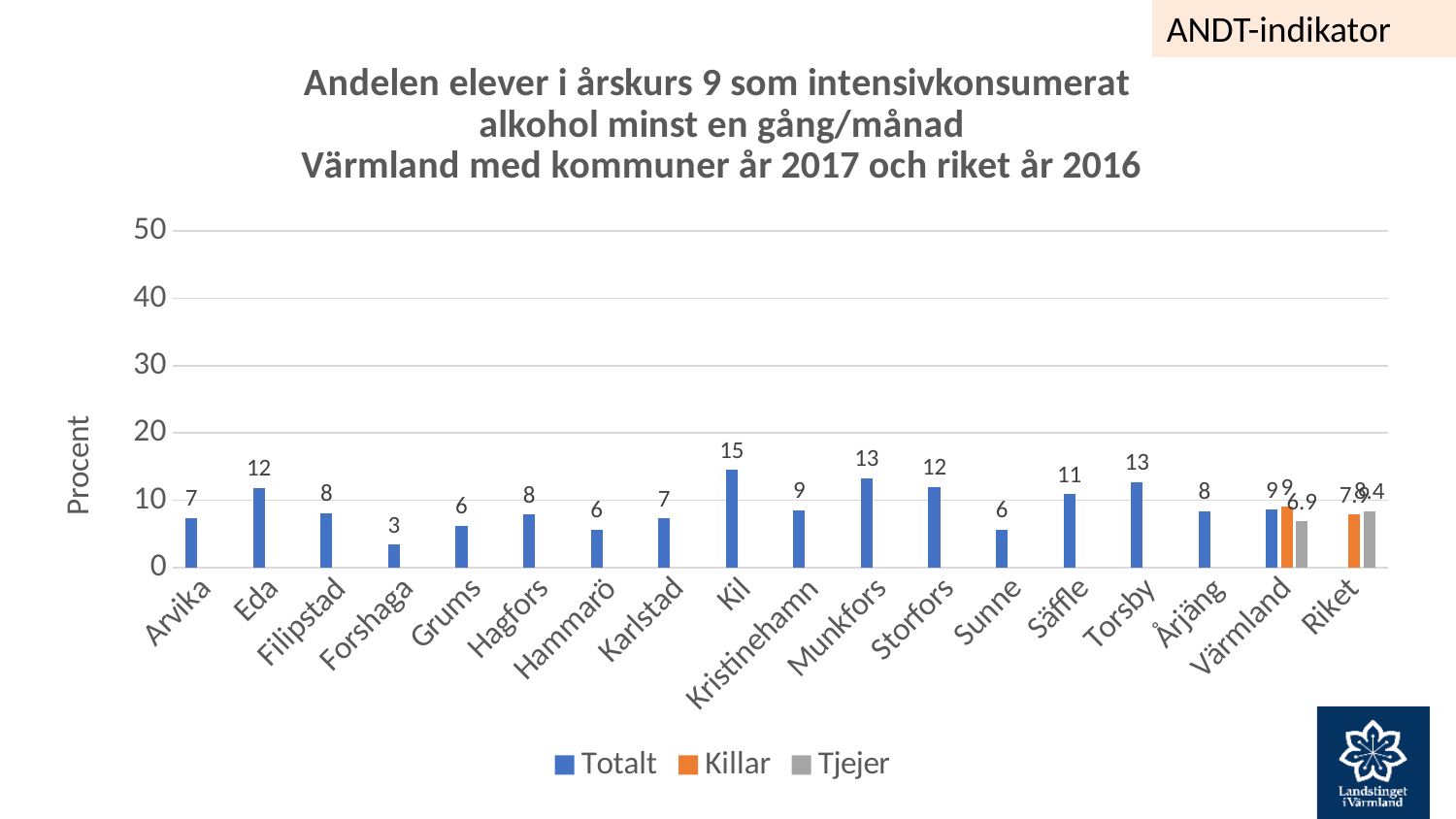
What is the Tjejer value for Värmland? 6.9 What is the Totalt value for Kil? 15 What is the label on the vertical axis? Procent Which category has the lowest Totalt value? Forshaga What is the Totalt value for Munkfors? 13 How many series does the legend list? 3 What kind of chart is shown on the slide? Bar chart What is the difference between the Totalt values for Eda and Arvika? 5 Which category has the highest Totalt value? Kil Is the Totalt value for Torsby greater or less than 20? less What is the Totalt value for Forshaga? 3 Which has a higher Totalt value, Säffle or Sunne? Säffle